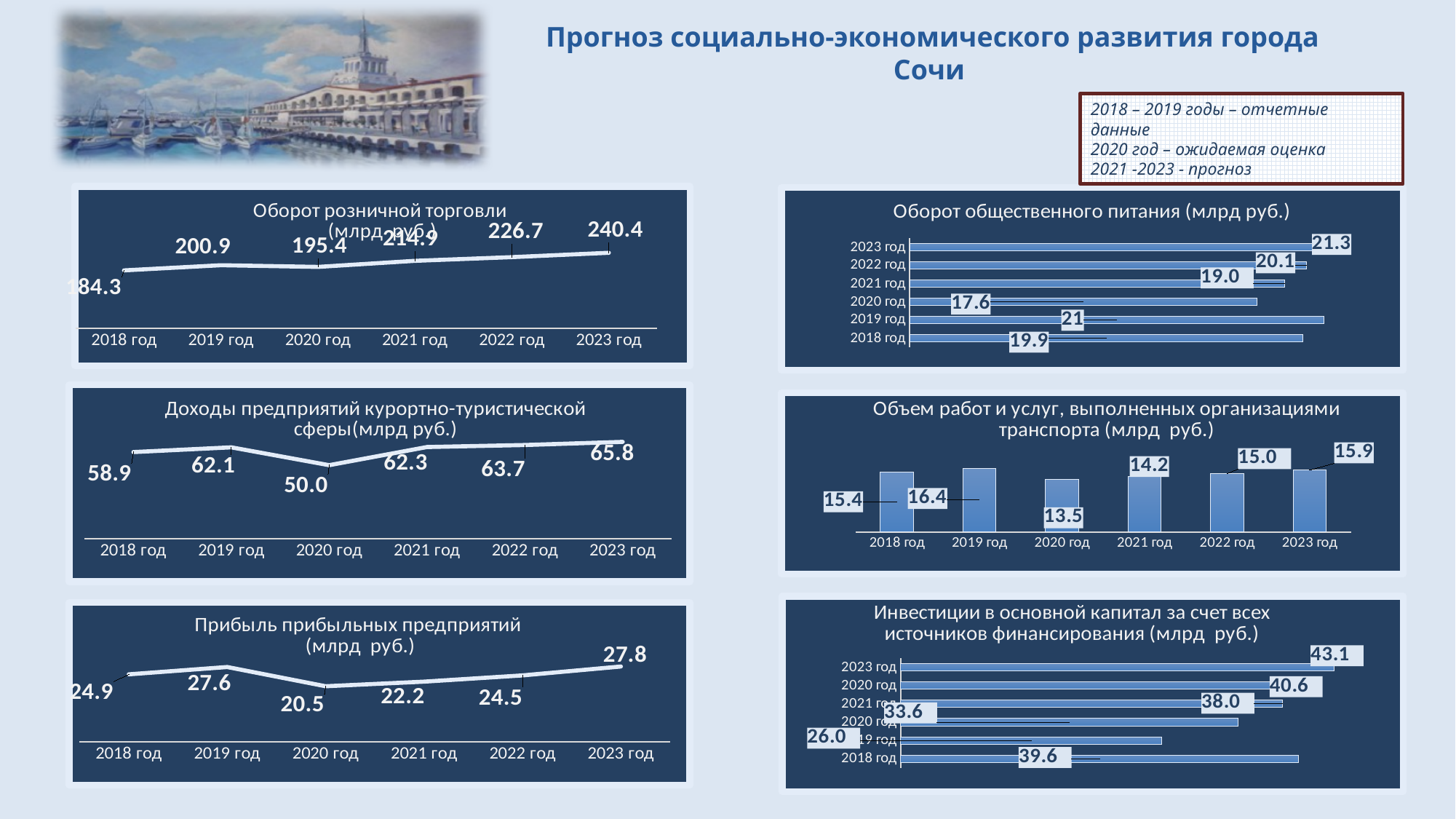
In the chart titled "Инвестиции в основной капитал за счет всех источников финансирования (млрд руб.)", what is the value for 2023 год? 43.1 In the chart titled "Объем работ и услуг, выполненных организациями транспорта (млрд руб.)", how many years are shown? 6 In the chart titled "Оборот розничной торговли (млрд руб.)", what is the difference between the values for 2023 год and 2022 год? 13.7 In the chart titled "Прибыль прибыльных предприятий (млрд руб.)", which year has the highest value? 2023 год In the chart titled "Доходы предприятий курортно-туристической сферы (млрд руб.)", which year has the lowest value? 2020 год What kind of chart is the one titled "Объем работ и услуг, выполненных организациями транспорта (млрд руб.)"? bar chart In the chart titled "Оборот общественного питания (млрд руб.)", which is larger, the value for 2019 год or the value for 2021 год? 2019 год In the chart titled "Оборот розничной торговли (млрд руб.)", what is the value for 2018 год? 184.3 In the chart titled "Оборот розничной торговли (млрд руб.)", what is the value for 2023 год? 240.4 In the chart titled "Прибыль прибыльных предприятий (млрд руб.)", what is the value for 2020 год? 20.5 In the chart titled "Доходы предприятий курортно-туристической сферы (млрд руб.)", what is the value for 2022 год? 63.7 In the chart titled "Оборот общественного питания (млрд руб.)", what is the value for 2020 год? 17.6